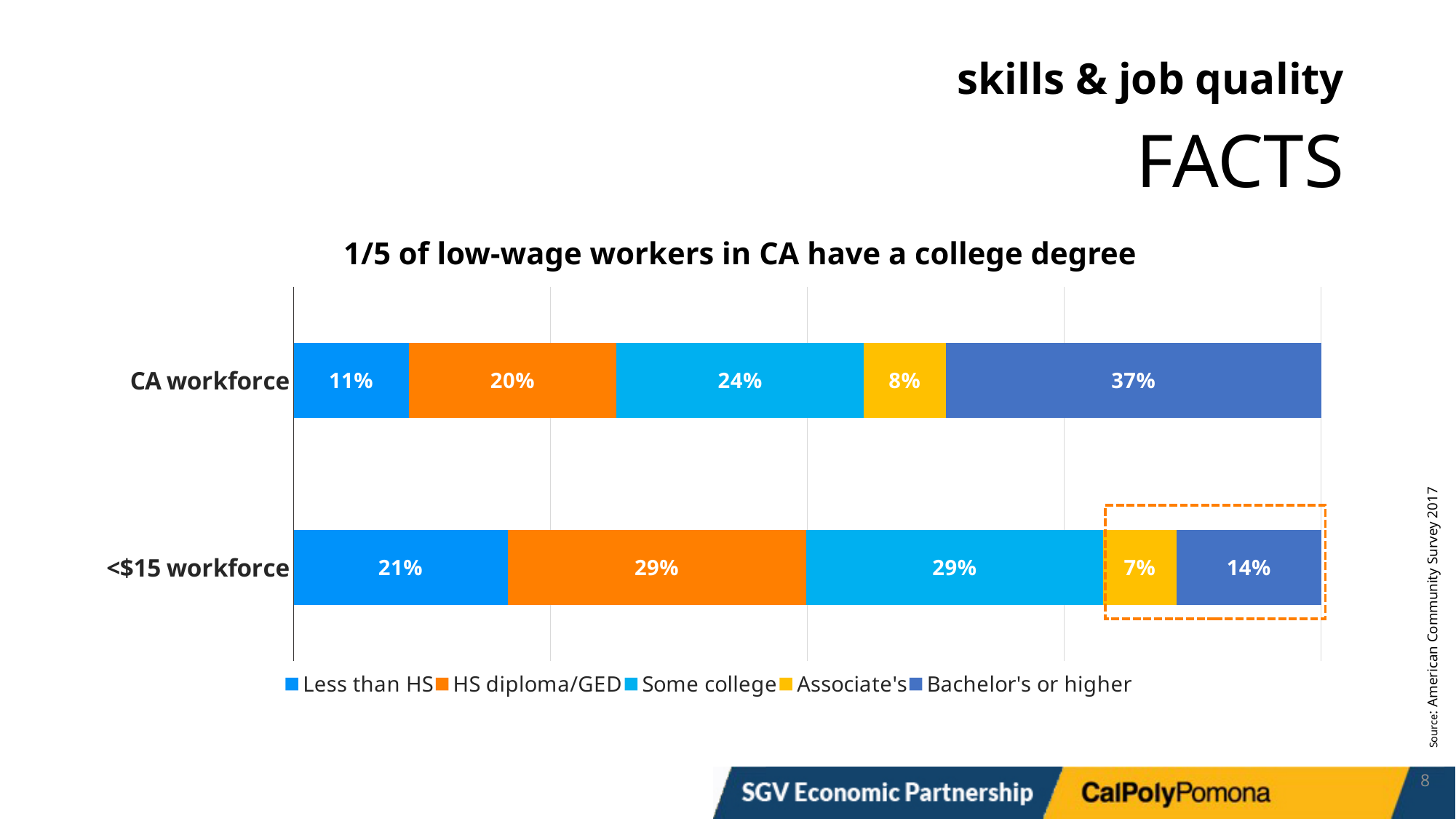
What is the title of the chart? 1/5 of low-wage workers in CA have a college degree What percentage of the <$15 workforce has less than HS education? 21% What percentage of the CA workforce has a Bachelor's or higher? 37% How many series does the legend list? 5 Which education level has the smallest share of the <$15 workforce? Associate's How many workforce categories are shown on the chart? 2 What kind of chart is shown on the slide? Stacked bar chart What is the difference between the Bachelor's or higher share of the CA workforce and of the <$15 workforce? 23% Which education level has the largest share of the CA workforce? Bachelor's or higher What percentage of the CA workforce has some college? 24% What percentage of the <$15 workforce has an Associate's degree? 7% Which has a larger HS diploma/GED share, the CA workforce or the <$15 workforce? <$15 workforce